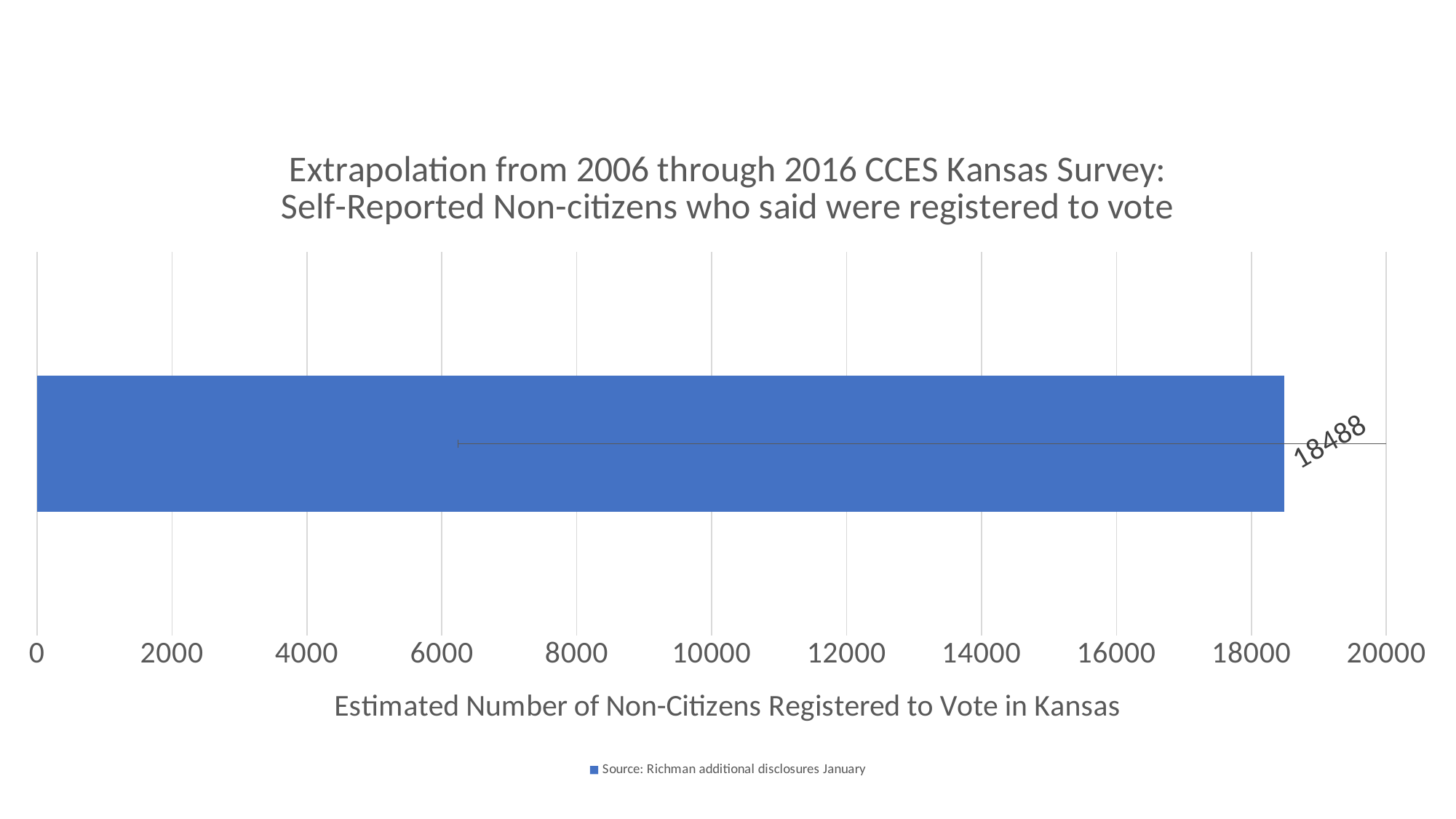
What kind of chart is shown on the slide? bar chart What is the x-axis title of the chart? Estimated Number of Non-Citizens Registered to Vote in Kansas How many series does the legend list? 1 What value is shown by the bar in the chart? 18488 How many bars are plotted in the chart? 1 Is the value of the bar greater or less than 20000? less What is the legend entry shown below the chart? Source: Richman additional disclosures January Is the value of the bar greater or less than 18000? greater What is the maximum value shown on the x axis? 20000